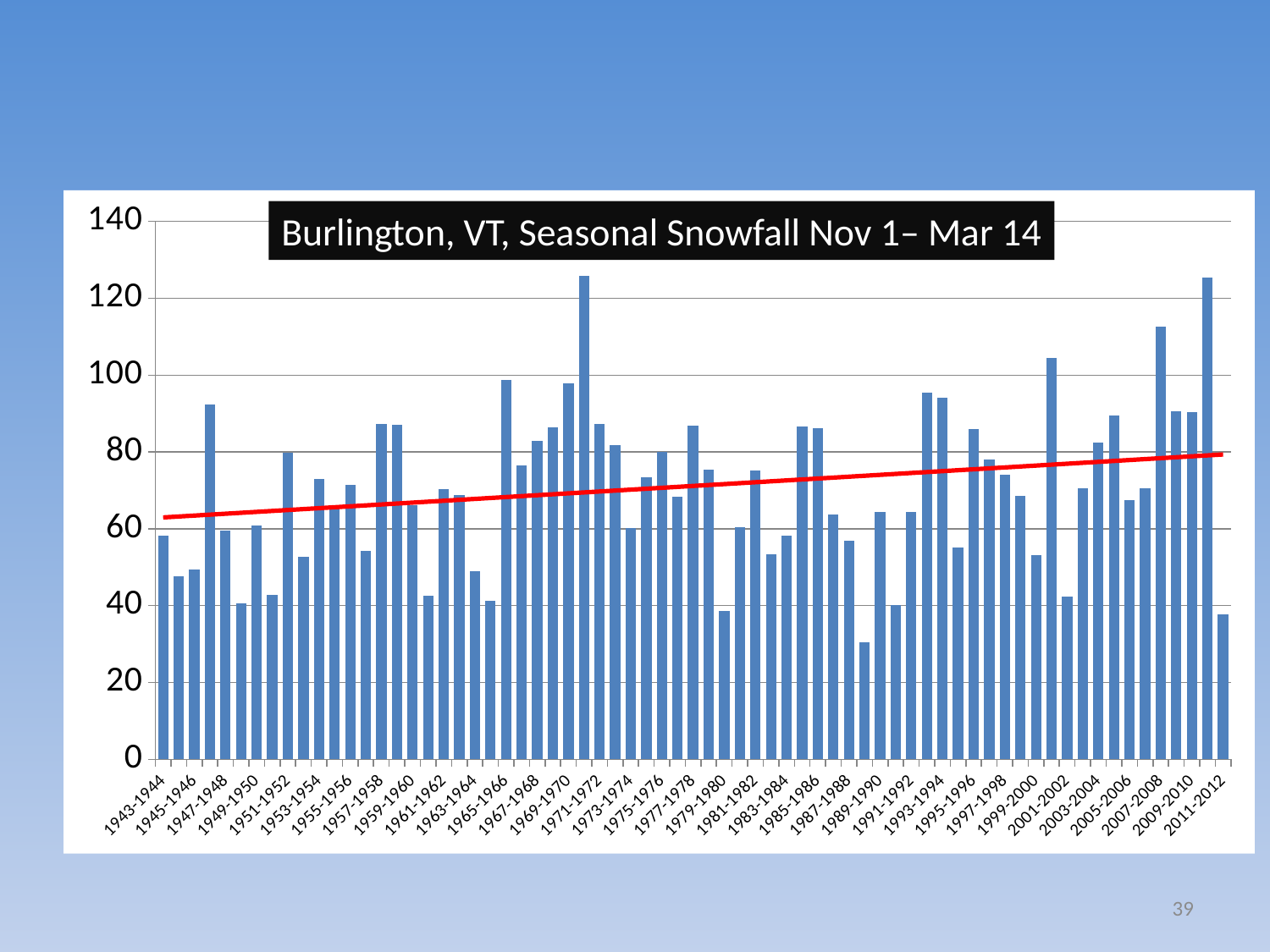
Is the value for 1989-1990 greater or less than 40? greater What is the title of the chart? Burlington, VT, Seasonal Snowfall Nov 1– Mar 14 Which season has the larger snowfall value, 1971-1972 or 1989-1990? 1971-1972 Does the red trend line rise or fall from left to right across the seasons? rises What colour is the trend line drawn across the bars? red Which season has the lowest snowfall bar? 1988-1989 What kind of chart is shown on the slide? bar chart Is the value for 1947-1948 greater or less than 80? less Is the value for 1943-1944 greater or less than 60? less